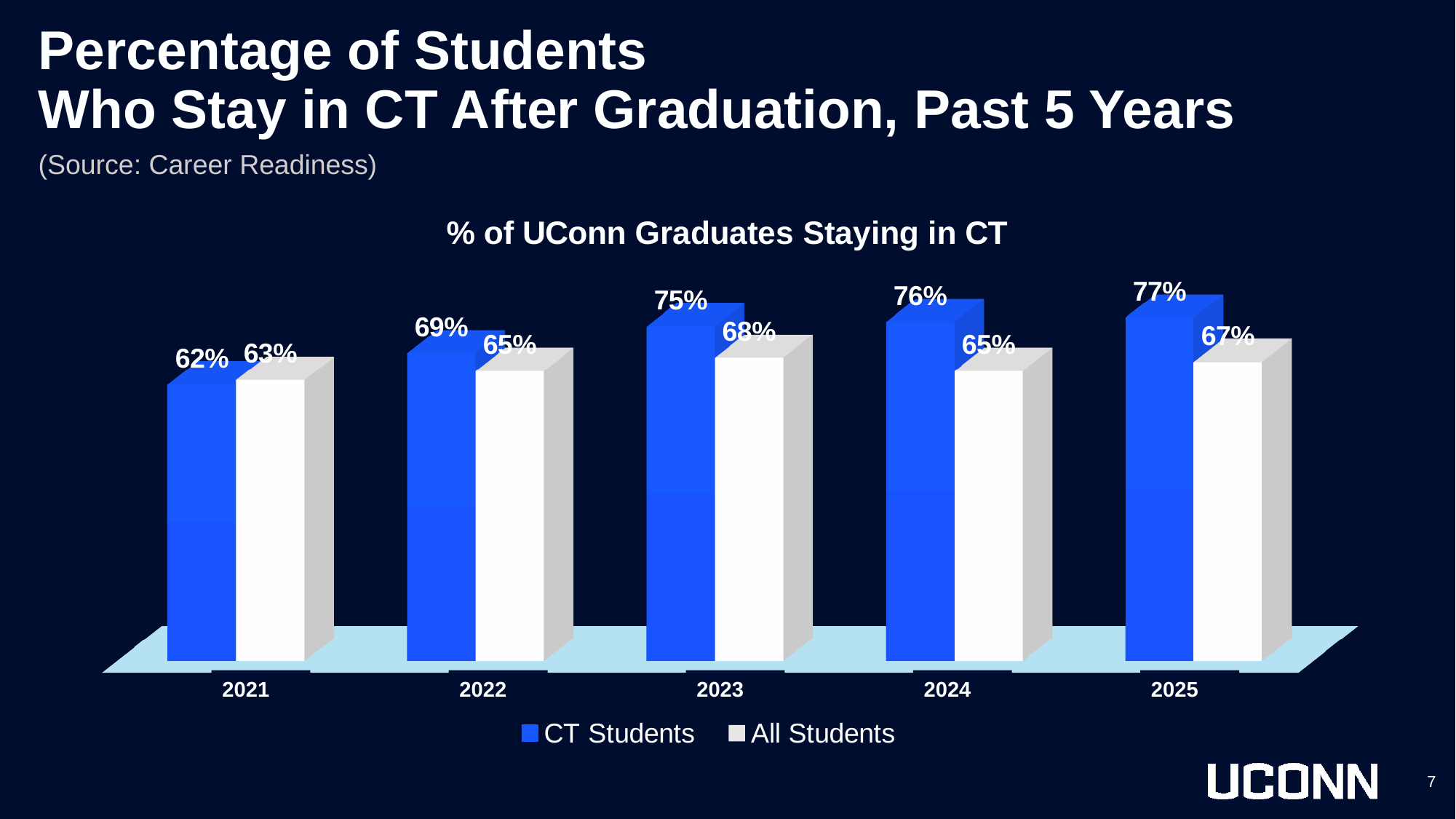
What kind of chart is this? Bar chart What is the difference between CT Students and All Students in 2024? 11% Do the CT Students values rise or fall from 2021 to 2025? Rise How many series does the legend list? 2 What is the value for All Students in 2025? 67% Which year has the highest value for CT Students? 2025 How many years are shown on the x axis? 5 What is the title of the chart? % of UConn Graduates Staying in CT Which is larger in 2021, CT Students or All Students? All Students Which year has the lowest value for All Students? 2021 What is the value for CT Students in 2023? 75% What is the value for All Students in 2021? 63%